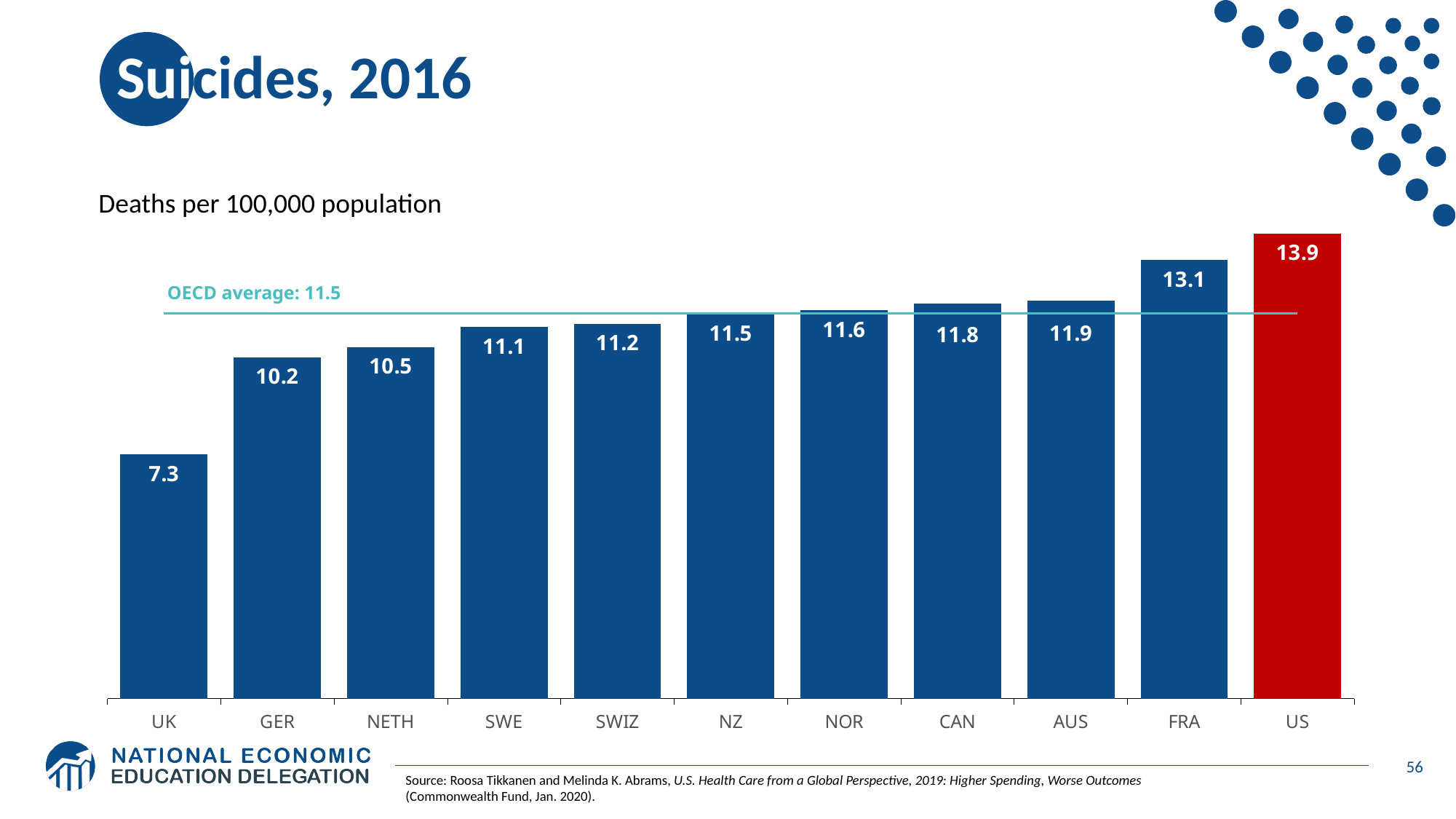
Which country has the highest suicide rate on the chart? US What is the difference between the US value and the UK value? 6.6 Do the values rise or fall moving from left to right across the chart? Rise What is the value shown for GER? 10.2 What is the difference between the FRA value and the AUS value? 1.2 How many countries are shown on the chart? 11 Which country has the lowest suicide rate on the chart? UK Which has a higher value, SWE or CAN? CAN What OECD average value is marked by the horizontal line on the chart? 11.5 What kind of chart is shown on the slide? Bar chart What is the value shown for NOR? 11.6 What is the suicide rate shown for the US? 13.9